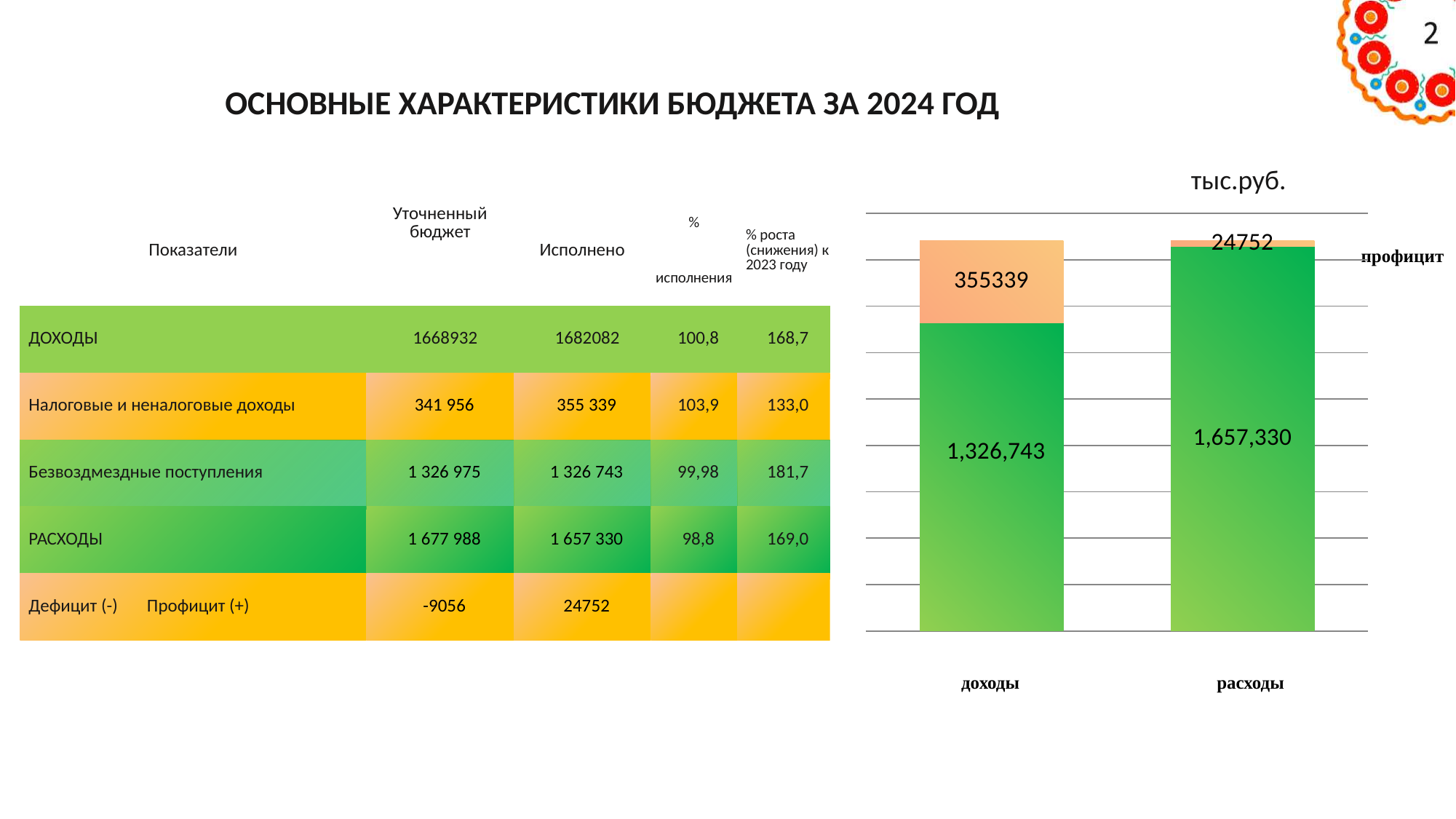
What kind of chart is shown on the right of the slide? stacked bar chart What unit is written above the chart? тыс.руб. What is the total of the доходы stacked bar? 1,682,082 What is the value of the green segment of the расходы bar? 1,657,330 How many categories are shown on the x axis of the chart? 2 What is the value of the orange segment of the доходы bar? 355339 Which bar has the larger green segment, доходы or расходы? расходы What label is written next to the top of the расходы bar? профицит What is the value of the green segment of the доходы bar? 1,326,743 Which bar has the larger orange segment, доходы or расходы? доходы What is the difference between the green segments of the расходы and доходы bars? 330,587 What is the value of the small orange segment on top of the расходы bar? 24752